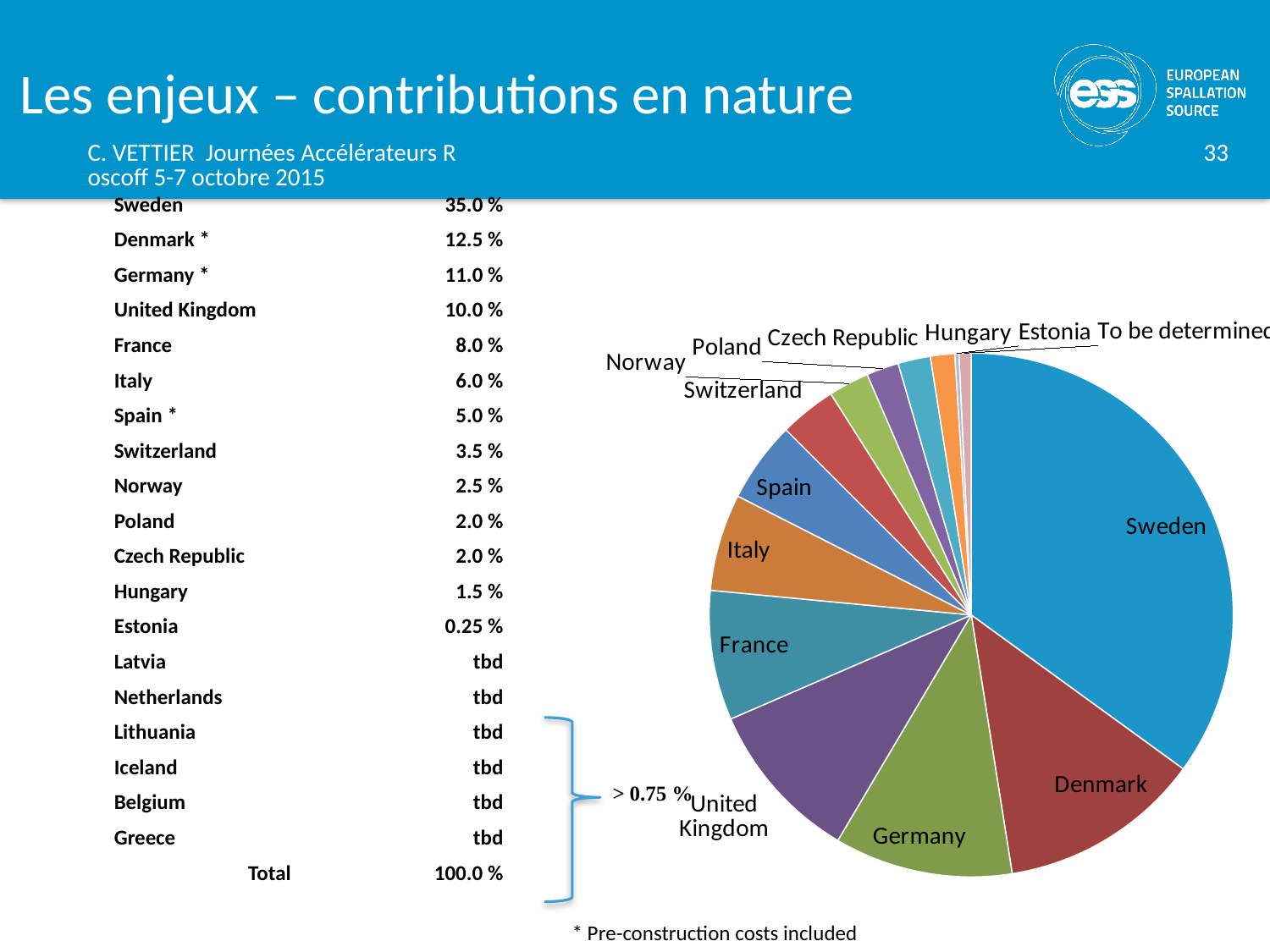
What is the label of the last slice in the pie chart, after Estonia? To be determined Which slice is larger in the pie chart, Sweden or Denmark? Sweden What is the difference between the contributions of Sweden and Denmark? 22.5 % Which country has the largest slice of the pie chart? Sweden Which slice is larger in the pie chart, United Kingdom or France? United Kingdom What share of the pie does Denmark represent? 12.5 % What is the contribution value for Switzerland? 3.5 % How many slices does the pie chart have? 14 Which named country has the smallest slice in the pie chart? Estonia What kind of chart is shown on the slide? pie chart What is the contribution value for France? 8.0 % What is the contribution value for Sweden? 35.0 %